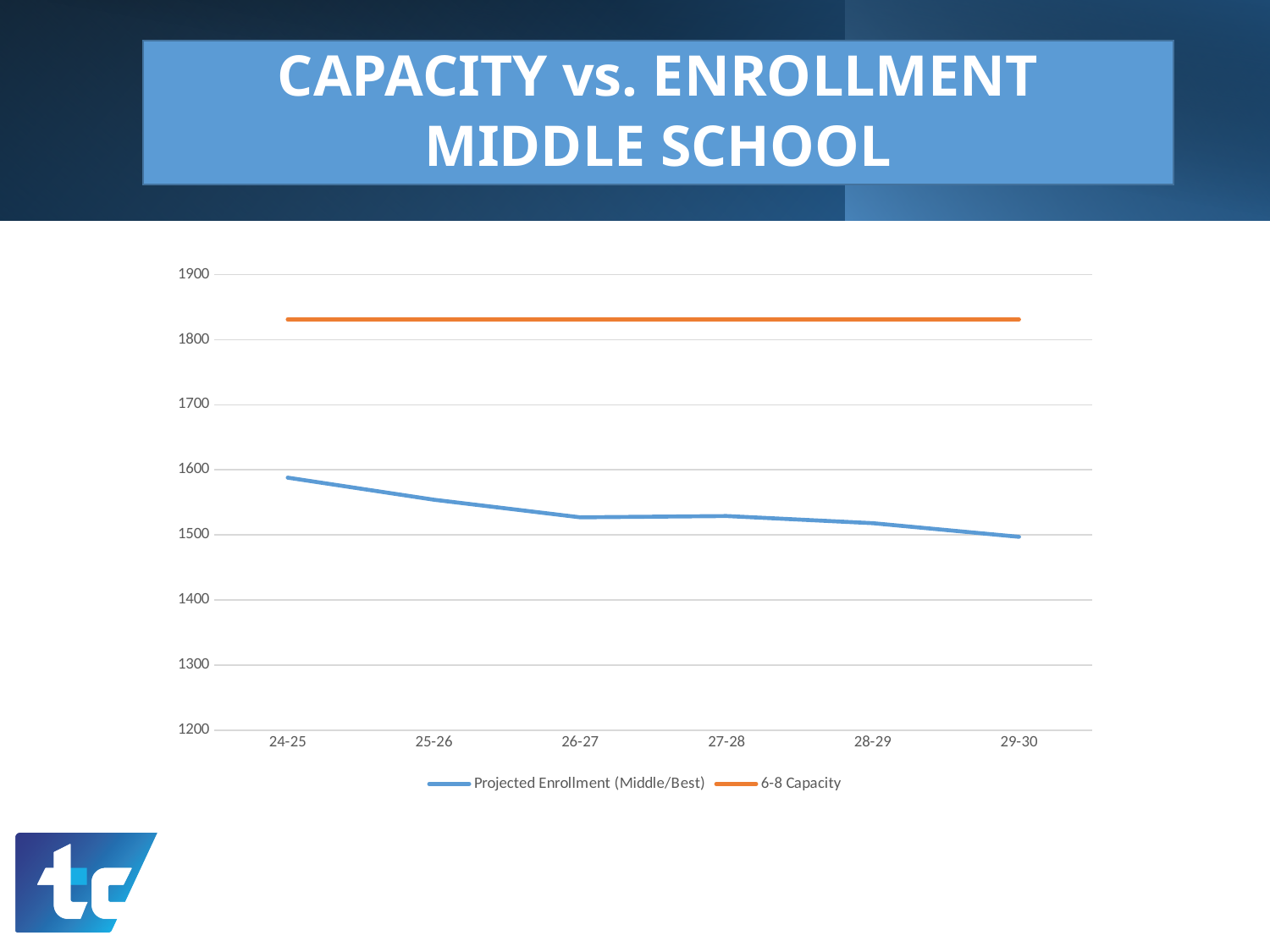
How many series does the legend list? 2 Which is larger in 27-28, the 6-8 Capacity or the Projected Enrollment (Middle/Best)? 6-8 Capacity What kind of chart is shown on the slide? line chart Is the 6-8 Capacity value greater or less than 1800? greater Does the Projected Enrollment (Middle/Best) line generally rise or fall from 24-25 to 29-30? fall Is the Projected Enrollment (Middle/Best) value for 24-25 greater or less than 1600? less What colour is the 6-8 Capacity line? orange In which school year is the Projected Enrollment (Middle/Best) highest? 24-25 In which school year is the Projected Enrollment (Middle/Best) lowest? 29-30 How many school years are shown on the x axis? 6 Is the Projected Enrollment (Middle/Best) value for 26-27 greater or less than 1500? greater